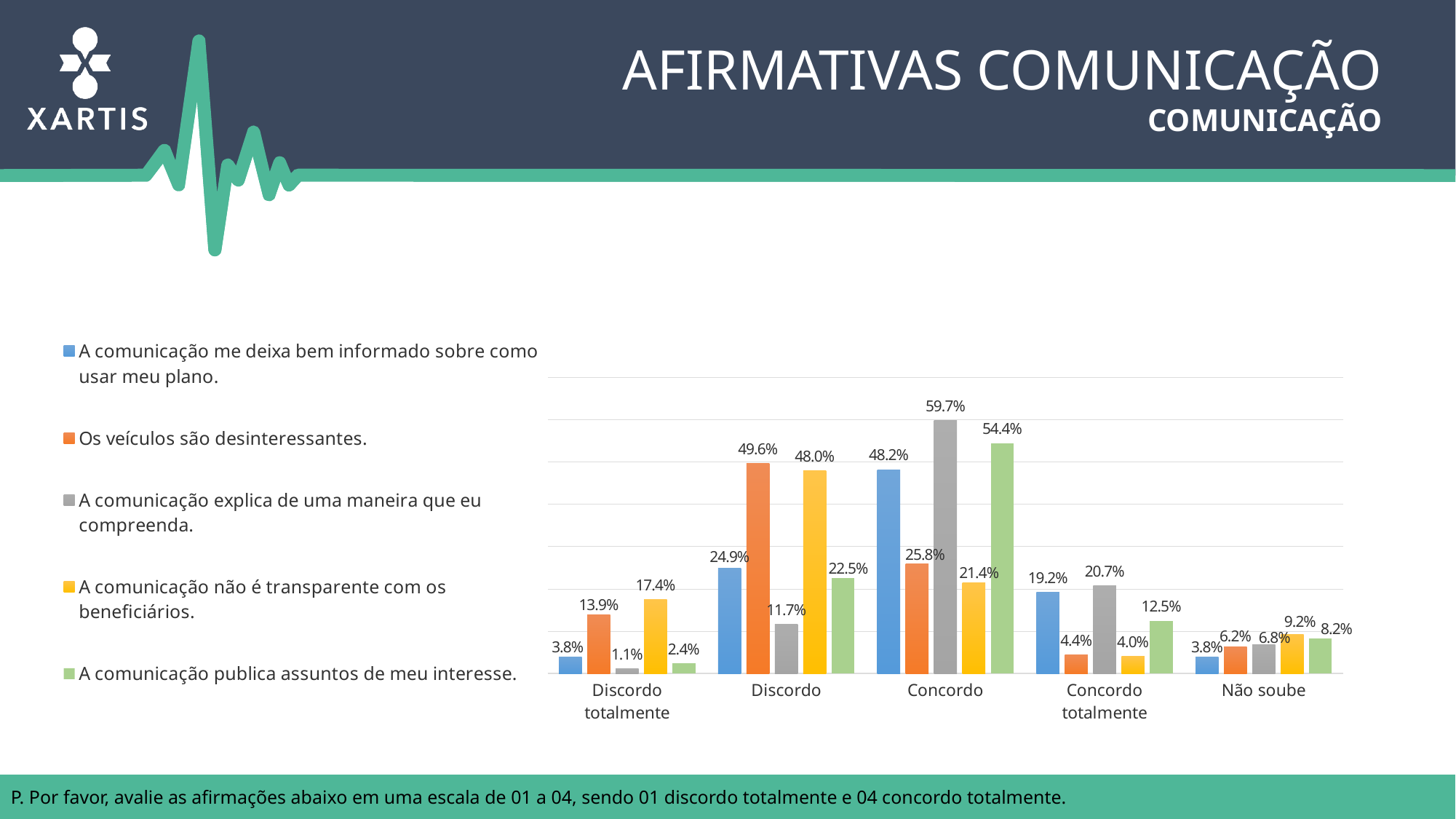
How many categories are shown on the x axis of the chart? 5 What kind of chart is shown on the slide? Bar chart What is the value for "A comunicação publica assuntos de meu interesse" in the Concordo totalmente category? 12.5% How many series does the legend list? 5 What is the value for "A comunicação explica de uma maneira que eu compreenda" in the Concordo category? 59.7% What is the value for "Os veículos são desinteressantes" in the Discordo category? 49.6% What is the difference between the values for "A comunicação explica de uma maneira que eu compreenda" and "A comunicação me deixa bem informado sobre como usar meu plano" in the Concordo category? 11.5% What is the value for "A comunicação não é transparente com os beneficiários" in the Não soube category? 9.2% Which series has the highest value in the Discordo totalmente category? A comunicação não é transparente com os beneficiários. In the Concordo totalmente category, which is larger: the value for "A comunicação me deixa bem informado sobre como usar meu plano" or for "A comunicação publica assuntos de meu interesse"? A comunicação me deixa bem informado sobre como usar meu plano. Which colour represents "Os veículos são desinteressantes" in the chart? Orange Which series has the lowest value in the Concordo category? A comunicação não é transparente com os beneficiários.